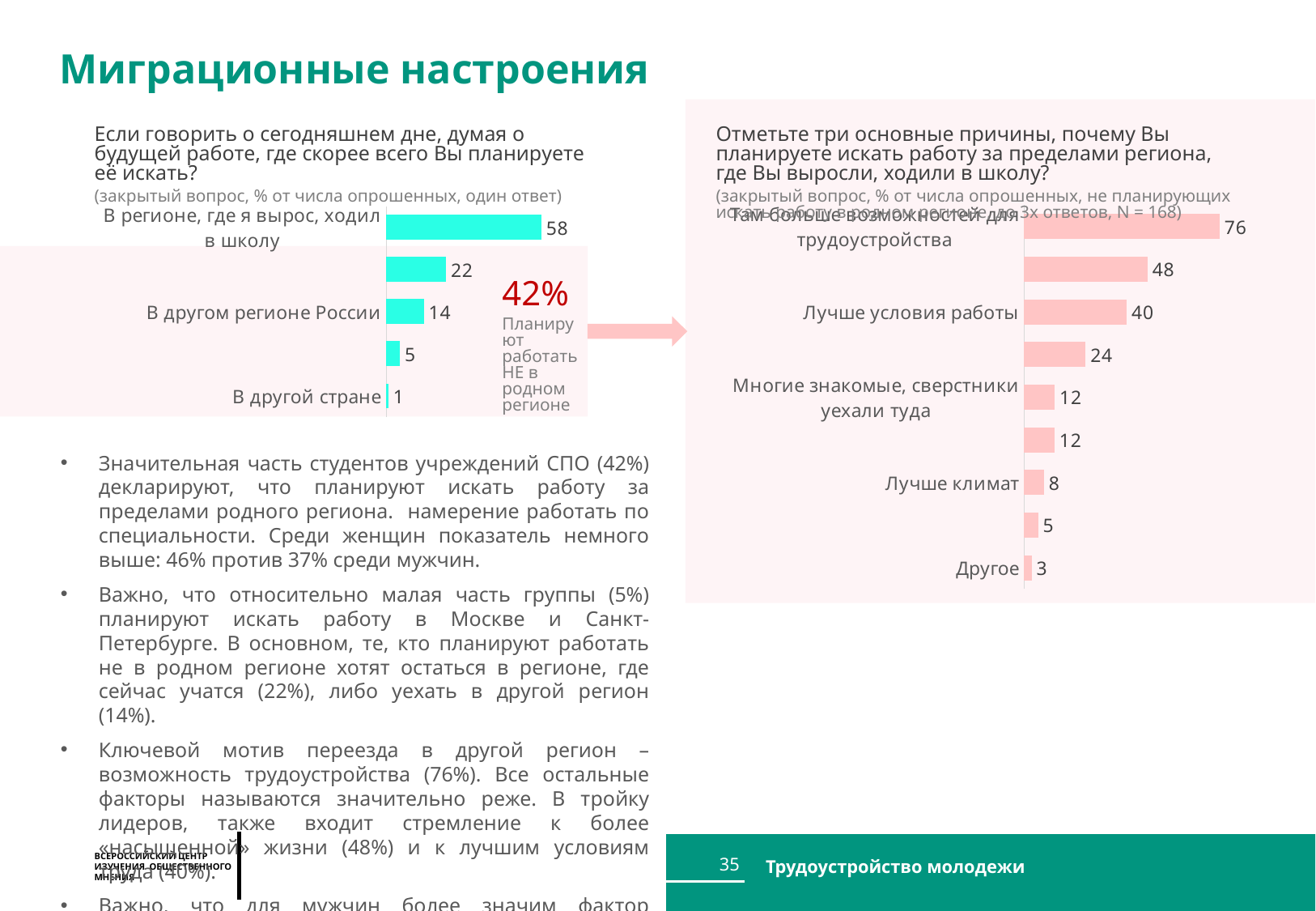
On the right chart, which is larger: 'Лучше условия работы' or 'Многие знакомые, сверстники уехали туда'? Лучше условия работы On the right chart, which category has the lowest value? Другое On the left chart, what is the value for 'В регионе, где я вырос, ходил в школу'? 58 On the left chart, what is the value for 'В другом регионе России'? 14 On the right chart, what is the value for 'Там больше возможностей для трудоустройства'? 76 On the left chart, what is the difference between the values for 'В регионе, где я вырос, ходил в школу' and 'В другом регионе России'? 44 On the left chart, how many bars are plotted? 5 On the right chart, how many bars are plotted? 9 What kind of chart is the right chart? Bar chart On the left chart, what is the value for 'В другой стране'? 1 On the right chart, what is the value for 'Лучше климат'? 8 On the right chart, what is the value for 'Лучше условия работы'? 40